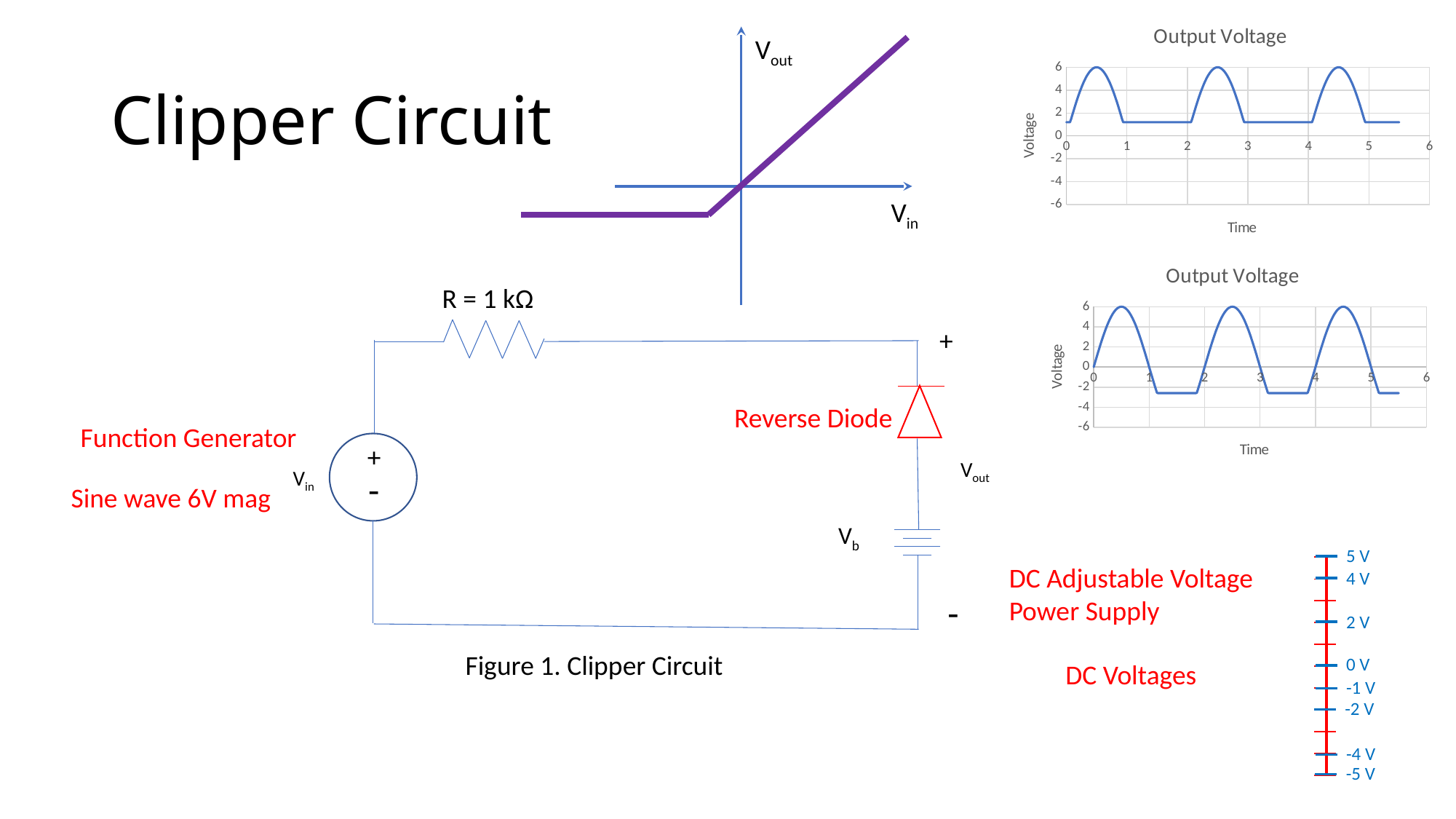
In the top 'Output Voltage' chart, is the flat clipped level of the waveform greater or less than 0? greater What kind of chart is the top 'Output Voltage' chart on the right of the slide? line chart In the top 'Output Voltage' chart, is the peak value of the waveform greater or less than 4? greater How many peaks does the waveform show in the bottom 'Output Voltage' chart? 3 In the bottom 'Output Voltage' chart, what is the title of the horizontal axis? Time What kind of chart is the bottom 'Output Voltage' chart on the right of the slide? line chart How many peaks does the waveform show in the top 'Output Voltage' chart? 3 In the bottom 'Output Voltage' chart, is the peak value of the waveform greater or less than 4? greater Which of the two 'Output Voltage' charts has the higher flat clipped level, the top chart or the bottom chart? top chart In the top 'Output Voltage' chart, what is the title of the vertical axis? Voltage